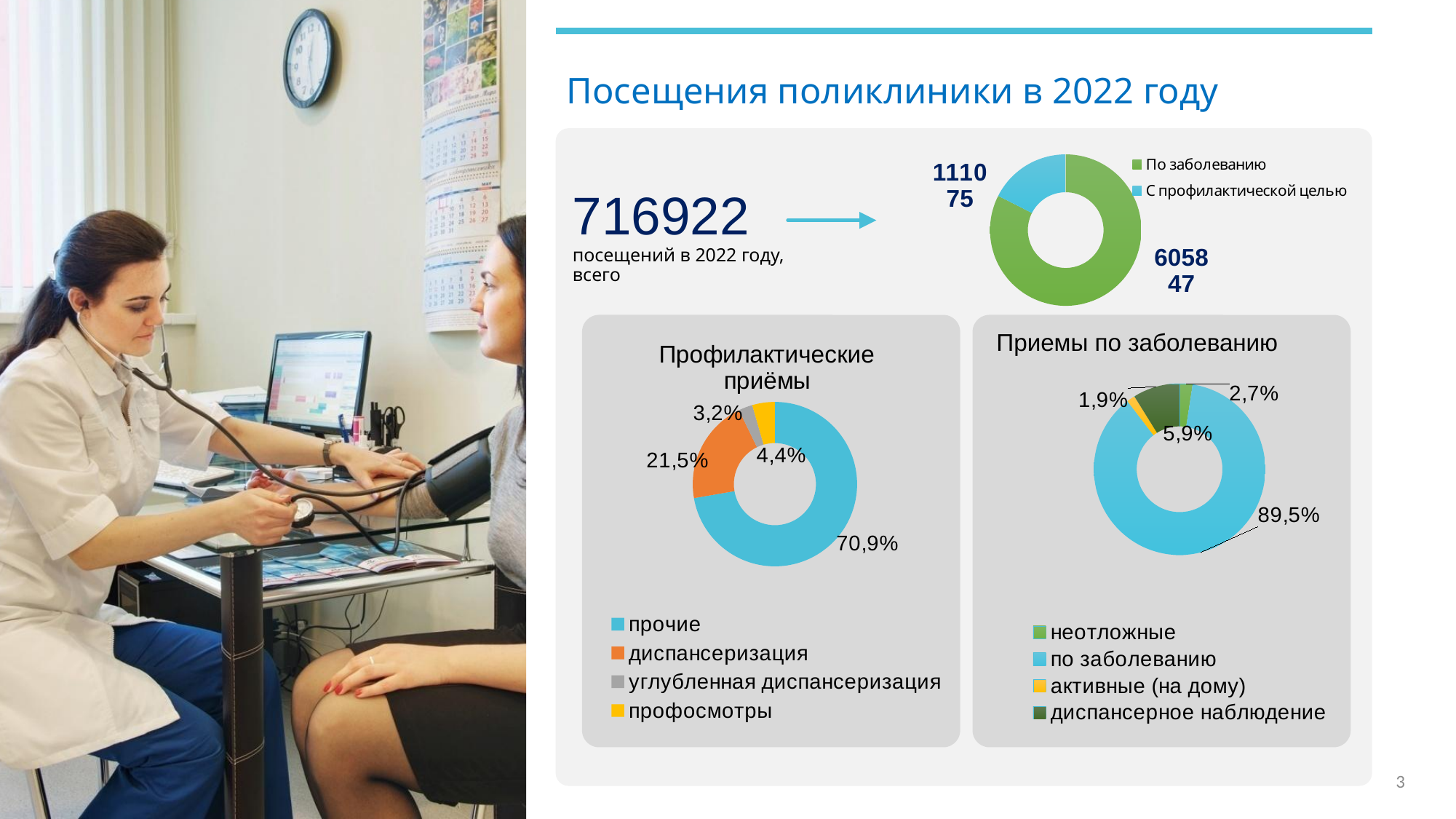
In the top donut chart, which category is larger: 'По заболеванию' or 'С профилактической целью'? По заболеванию In the 'Приемы по заболеванию' chart, which category has the smallest share? активные (на дому) What type of chart is the 'Приемы по заболеванию' chart? Donut (pie) chart In the 'Профилактические приёмы' chart, what is the difference between the shares of 'прочие' and 'диспансеризация'? 49,4% In the top donut chart, what is the value for 'По заболеванию'? 605847 In the top donut chart, what is the value for 'С профилактической целью'? 111075 In the 'Приемы по заболеванию' chart, what share does 'диспансерное наблюдение' have? 5,9% In the 'Приемы по заболеванию' chart, what share does 'по заболеванию' have? 89,5% How many categories does the legend of the 'Профилактические приёмы' chart list? 4 In the 'Профилактические приёмы' chart, what share does 'диспансеризация' have? 21,5% In the 'Профилактические приёмы' chart, what share does 'прочие' have? 70,9% In the 'Профилактические приёмы' chart, which category has the smallest share? углубленная диспансеризация